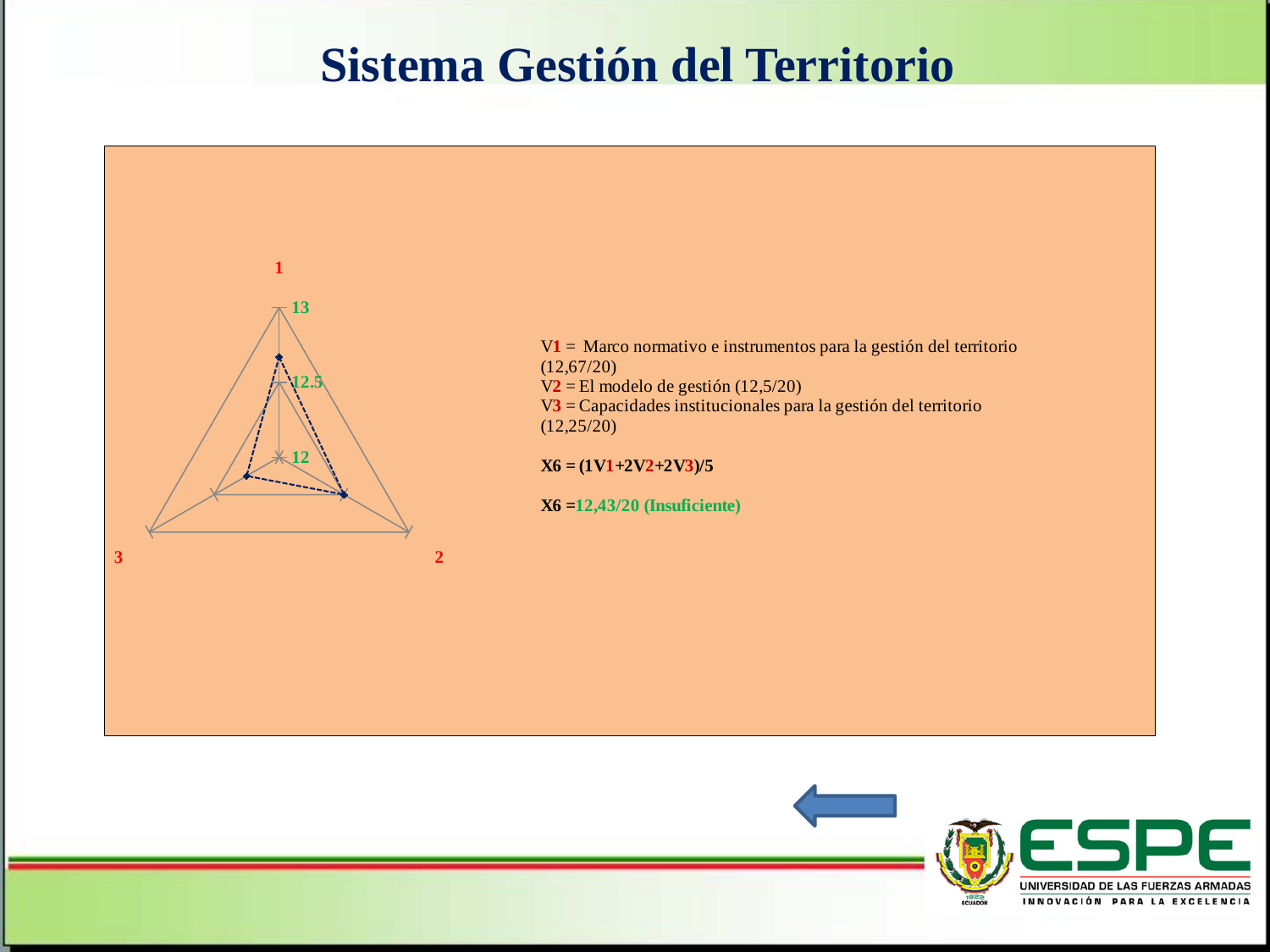
Which axis of the radar chart has the highest plotted value? 1 Which axis of the radar chart has the lowest plotted value? 3 What kind of chart is shown on the slide? radar chart How many axes (categories) does the radar chart have? 3 What is the value of the outermost ring of the radar chart? 13 Is the plotted value on axis 3 greater or less than 12.5? less Which has the larger plotted value on the radar chart, axis 1 or axis 3? 1 What is the value of the innermost ring of the radar chart? 12 Is the plotted value on axis 1 greater or less than 12.5? greater Is the plotted value on axis 3 greater or less than 12? greater